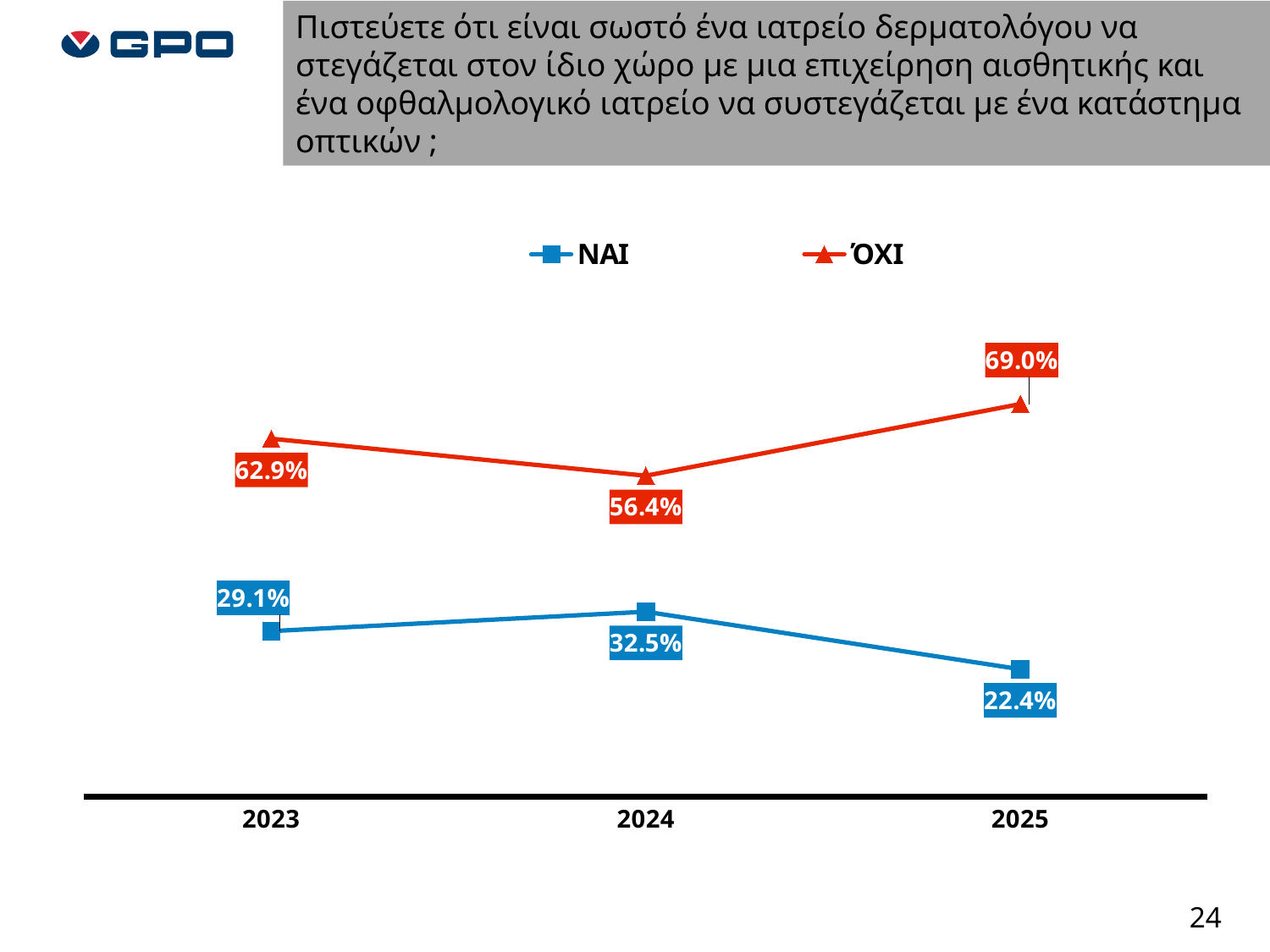
In which year is the ΝΑΙ value lowest? 2025 What is the value for ΌΧΙ in 2025? 69.0% What is the value for ΝΑΙ in 2024? 32.5% What is the value for ΝΑΙ in 2025? 22.4% What is the difference between the ΌΧΙ and ΝΑΙ values in 2025? 46.6% What kind of chart is shown on the slide? line chart How many series does the legend list? 2 In which year is the ΌΧΙ value highest? 2025 Which is larger in 2024, the ΝΑΙ value or the ΌΧΙ value? ΌΧΙ Does the ΝΑΙ value rise or fall from 2024 to 2025? fall How many years are shown on the x axis? 3 What is the value for ΌΧΙ in 2023? 62.9%